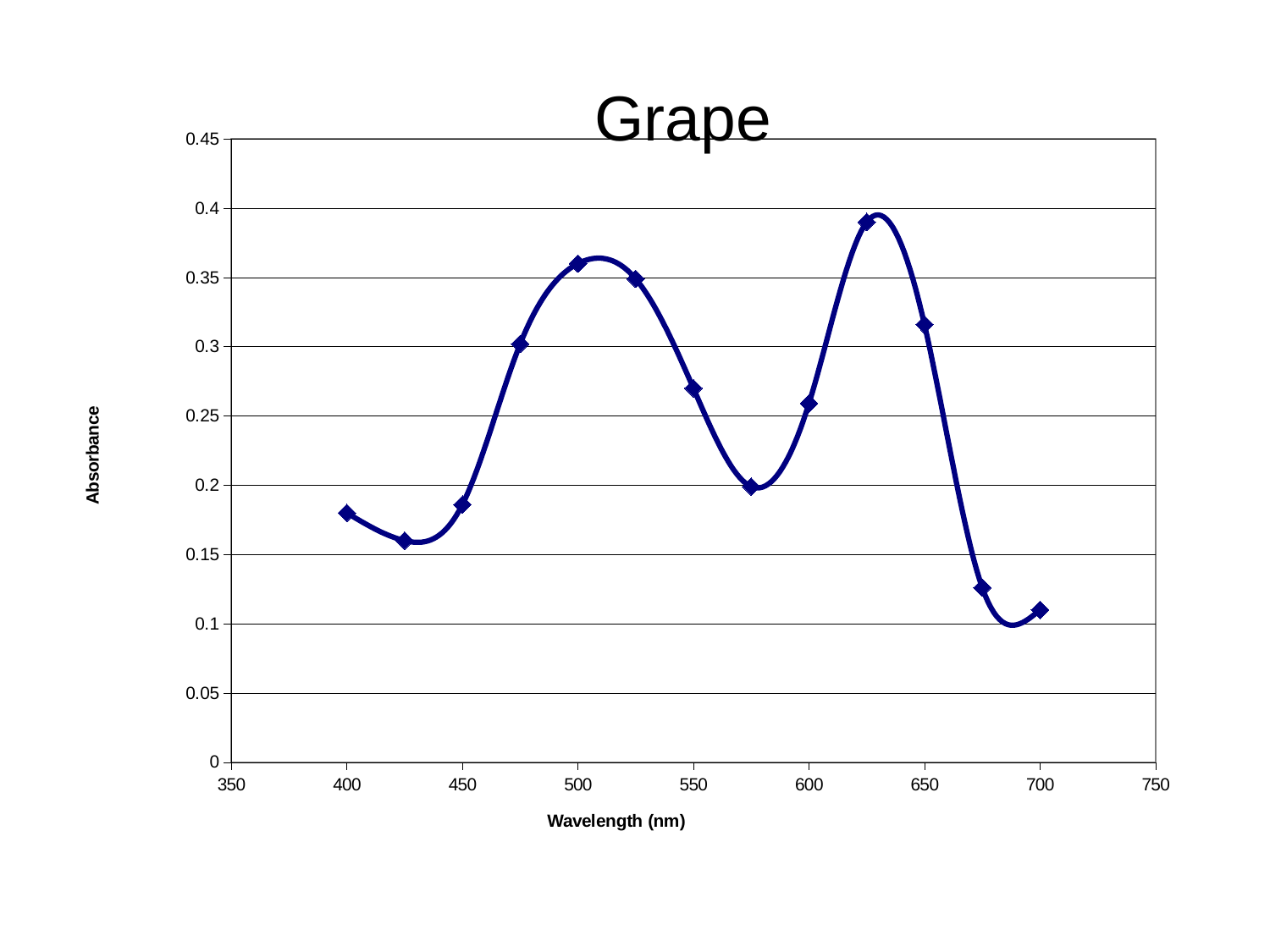
What is the label of the x axis? Wavelength (nm) Does the absorbance rise or fall between 650 nm and 700 nm? fall At which wavelength is the absorbance highest? 625 How many data points are plotted on the line? 13 Does the absorbance rise or fall between 425 nm and 500 nm? rise What is the title of the chart? Grape Is the absorbance at 625 nm greater or less than 0.35? greater Is the absorbance at 675 nm greater or less than 0.15? less Is the absorbance at 550 nm greater or less than 0.25? greater Which has the higher absorbance, 500 nm or 600 nm? 500 nm What kind of chart is shown on the slide? line chart